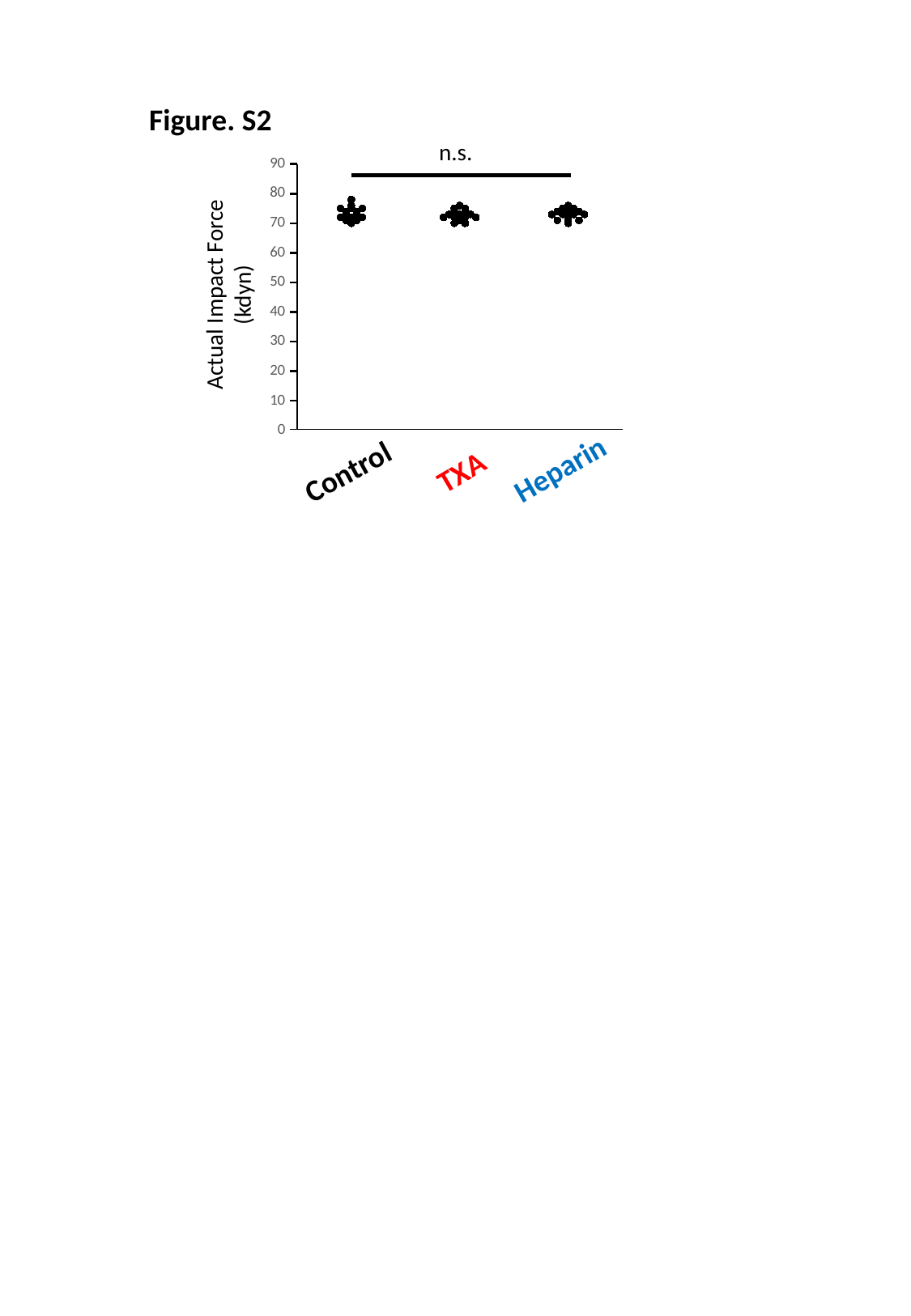
Are the values for the Control group greater or less than 90? less Are the values for the Control group greater or less than 60? greater What kind of chart is shown on the slide? Dot plot (scatter plot) What annotation is written above the bar spanning the three groups? n.s. What are the three groups labelled on the x axis? Control, TXA, Heparin What is the label of the y axis? Actual Impact Force (kdyn) How many groups are plotted along the x axis? 3 Are the values for the TXA group greater or less than 80? less